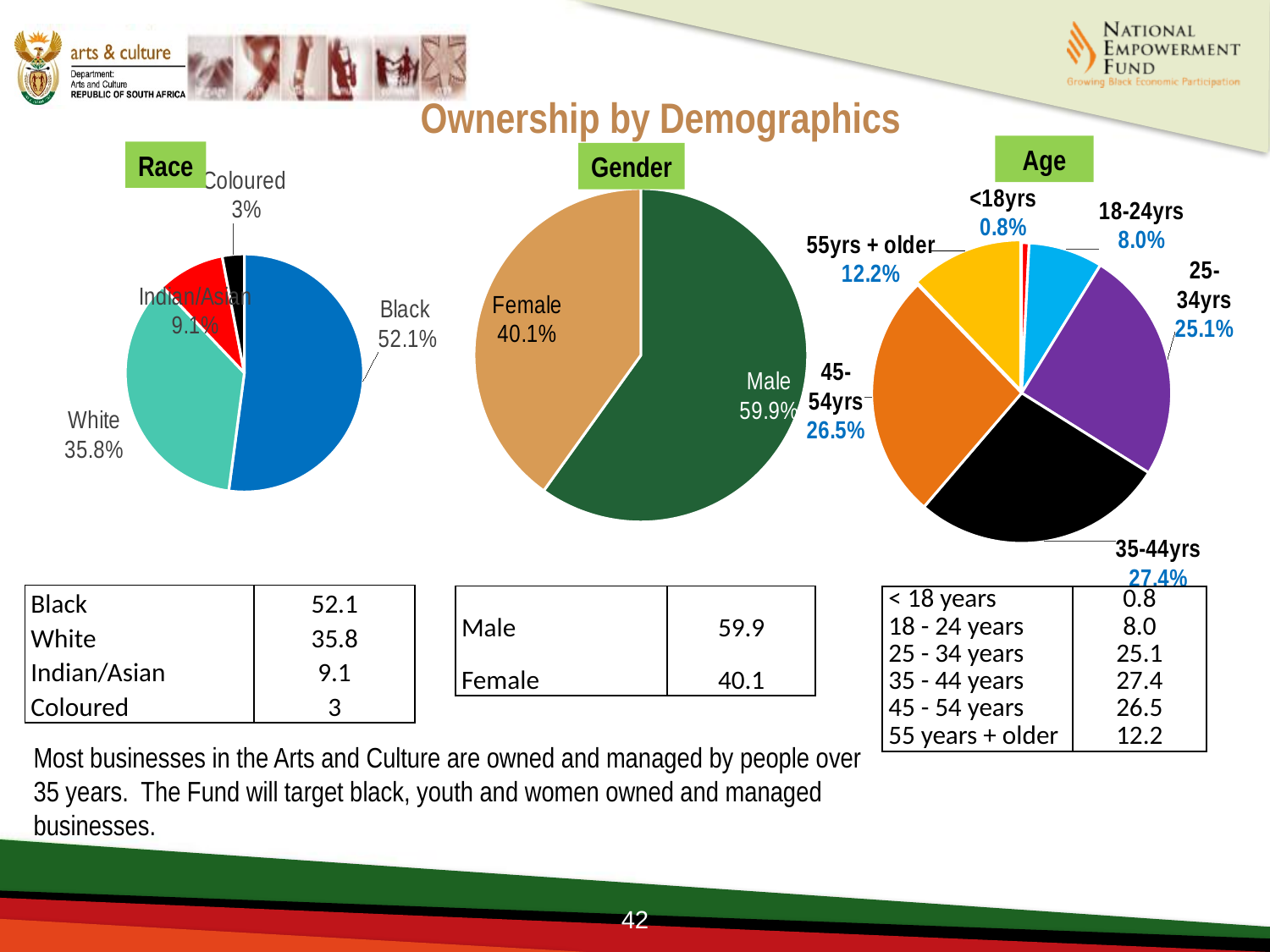
In the Age pie chart, how many age groups are shown? 6 In the Age pie chart, what share is labelled for 35-44yrs? 27.4% In the Age pie chart, which age group has the largest slice? 35-44yrs In the Age pie chart, which is larger: the share for 18-24yrs or the share for 55yrs + older? 55yrs + older In the Race pie chart, which category has the smallest slice? Coloured In the Race pie chart, how many categories are shown? 4 What kind of chart is the Gender chart? Pie chart In the Gender pie chart, what is the difference between the Male and Female shares? 19.8% In the Race pie chart, what share is labelled for White? 35.8% In the Gender pie chart, what share is labelled for Male? 59.9% In the Age pie chart, which age group has the smallest slice? <18yrs In the Race pie chart, what share is labelled for Black? 52.1%